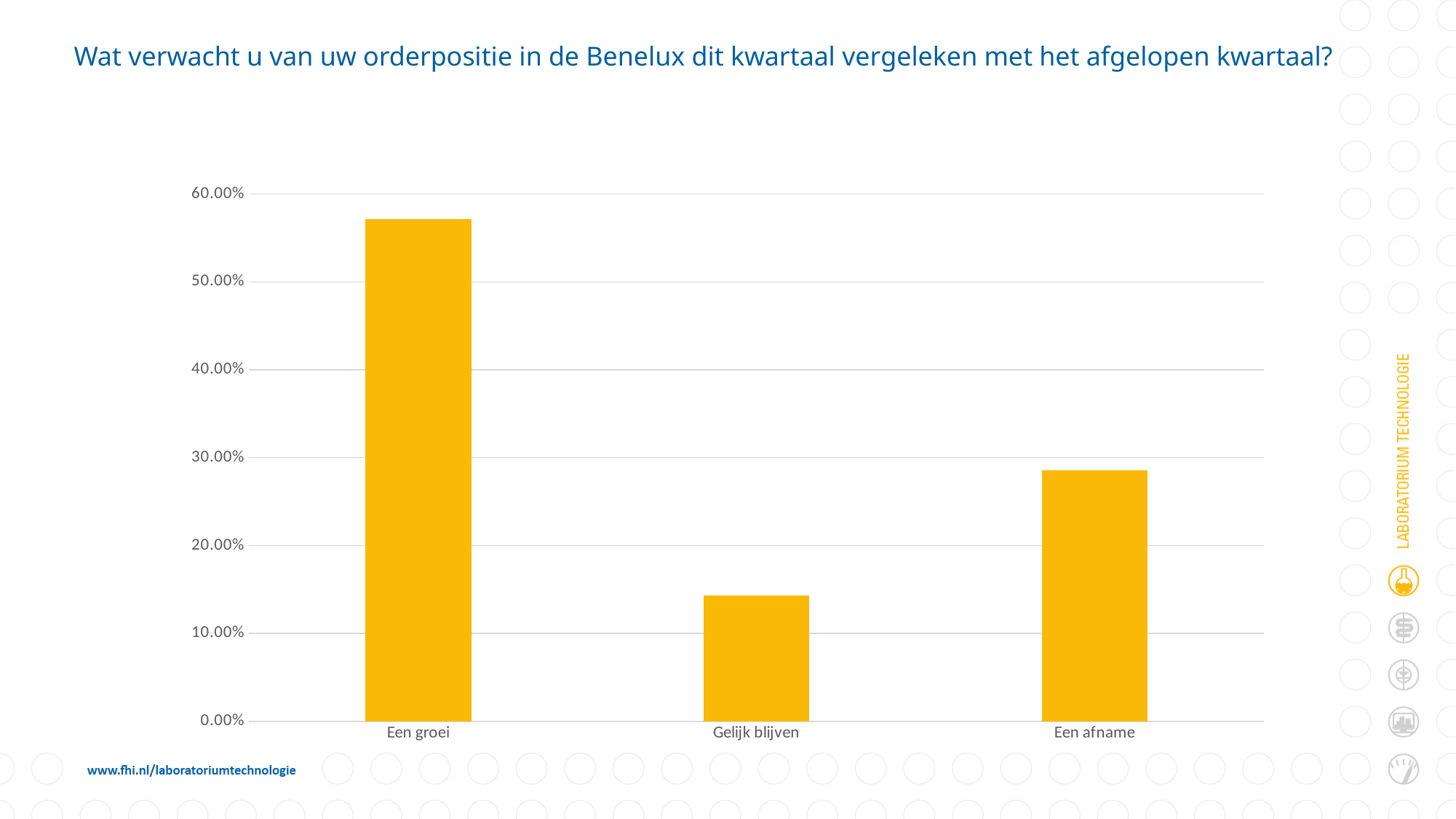
What is the title of the chart on the slide? Wat verwacht u van uw orderpositie in de Benelux dit kwartaal vergeleken met het afgelopen kwartaal? What kind of chart is shown on the slide? bar chart Which is larger, the value for Een groei or the value for Een afname? Een groei Which category has the lowest value in the chart? Gelijk blijven Which category has the highest value in the chart? Een groei How many categories are shown on the x axis of the chart? 3 Is the value for Gelijk blijven greater or less than 20.00%? less Which is larger, the value for Een afname or the value for Gelijk blijven? Een afname What colour are the bars in the chart? yellow Is the value for Een afname greater or less than 30.00%? less Is the value for Een afname greater or less than 20.00%? greater